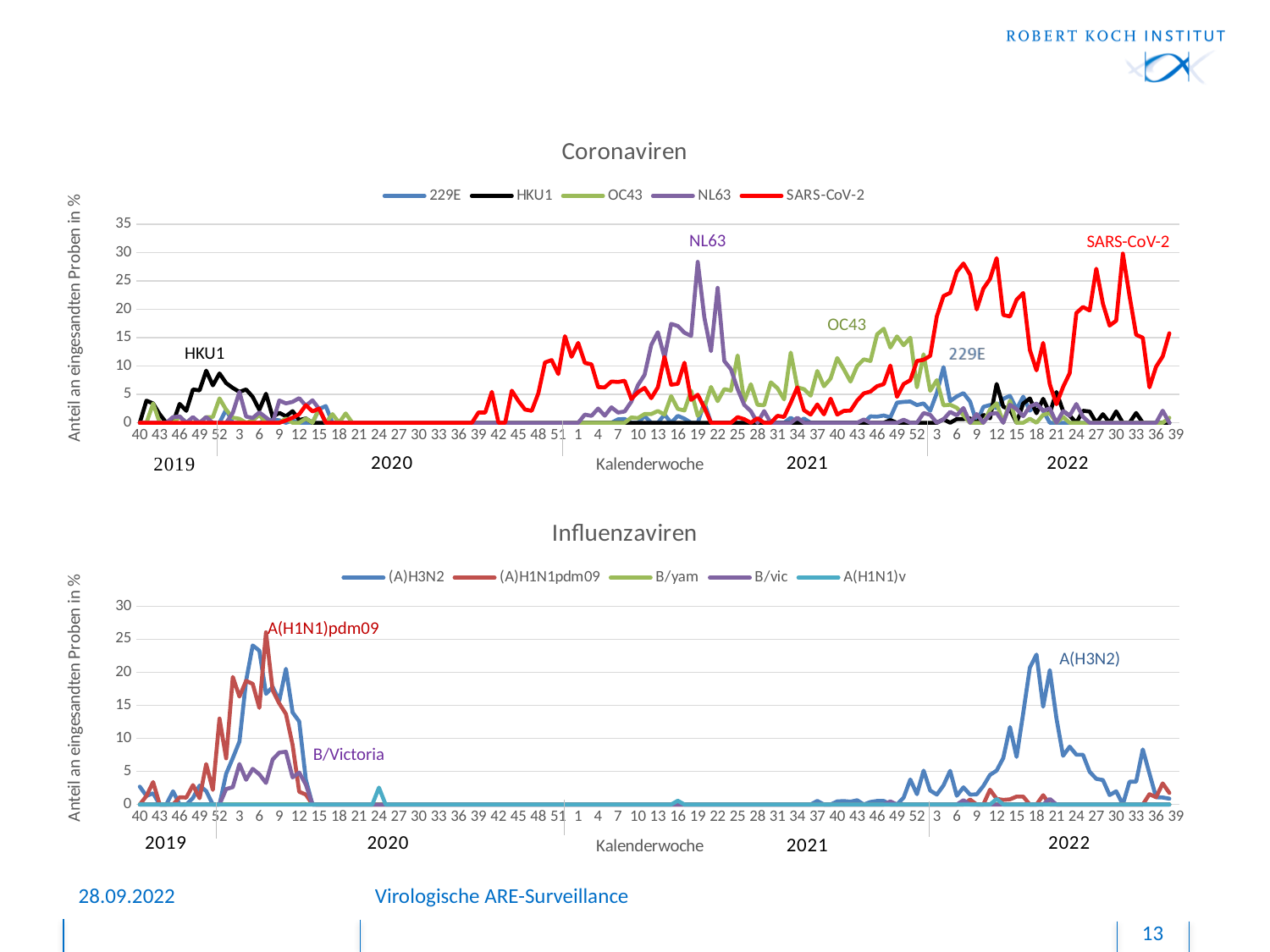
In the Influenzaviren chart, is the 2022 peak of A(H3N2) greater or less than 15? greater In the Influenzaviren chart, is the peak value of A(H1N1)pdm09 greater or less than 20? greater What is the x-axis label of the Influenzaviren chart? Kalenderwoche In the Coronaviren chart, is the peak value of OC43 greater or less than 10? greater How many years are marked along the x axis of the Coronaviren chart? 4 How many series does the legend of the Coronaviren chart list? 5 How many series does the legend of the Influenzaviren chart list? 5 What kind of chart is the Coronaviren chart? line chart In the Coronaviren chart, which series is plotted in red? SARS-CoV-2